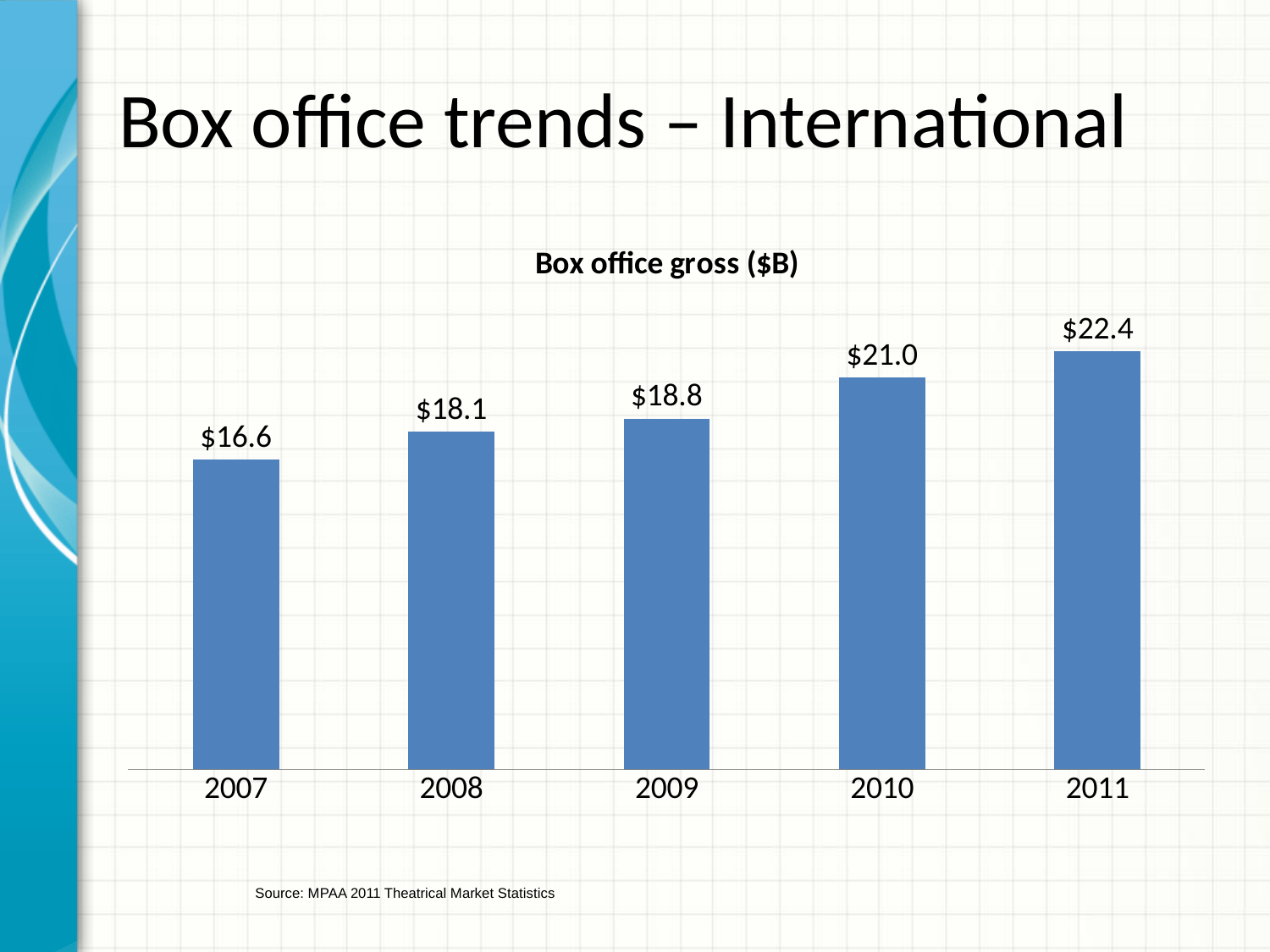
What is the box office gross for 2011? $22.4 What is the box office gross for 2009? $18.8 What is the box office gross for 2007? $16.6 What is the title of the chart? Box office gross ($B) What kind of chart is shown on the slide? Bar chart Do the box office gross values rise or fall from 2007 to 2011? Rise What is the difference in box office gross between 2011 and 2007? $5.8 Which year has the lowest box office gross? 2007 How many years are shown on the chart? 5 Which year has a larger box office gross, 2008 or 2010? 2010 Which year has the highest box office gross? 2011 What is the difference in box office gross between 2010 and 2009? $2.2